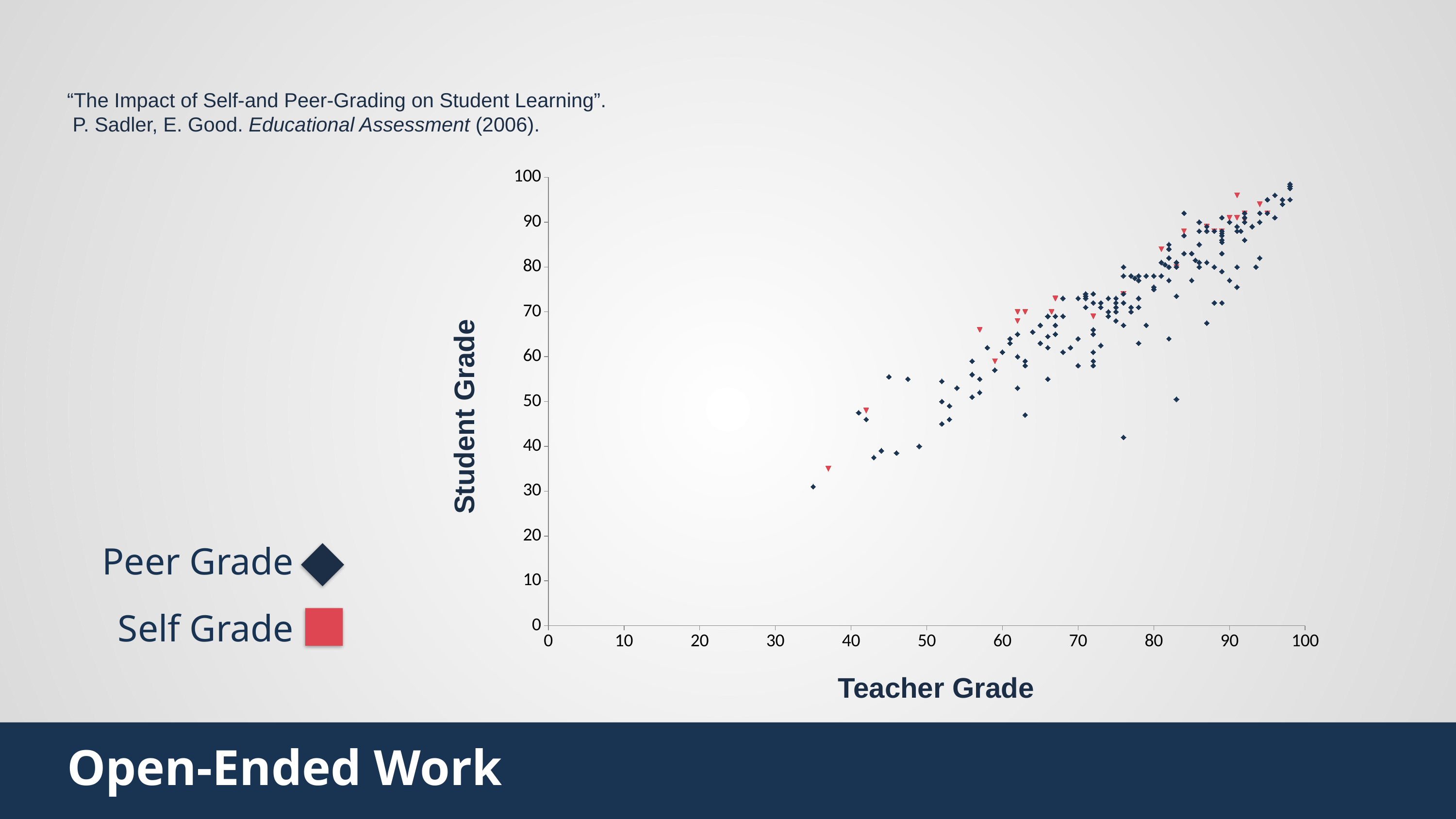
What is the highest value shown on the x axis? 100 What is the title of the y axis? Student Grade As Teacher Grade increases along the x axis, do the Student Grade values generally rise or fall? rise What kind of chart is shown on the slide? scatter chart Is the lowest Student Grade plotted on the chart greater or less than 40? less How many series does the legend list? 2 Which series is shown with red markers? Self Grade Is the highest Student Grade plotted on the chart greater or less than 90? greater Are there any points plotted with a Teacher Grade less than 30? No What is the title of the x axis? Teacher Grade What are the two series named in the legend? Peer Grade and Self Grade What is the highest value shown on the y axis? 100